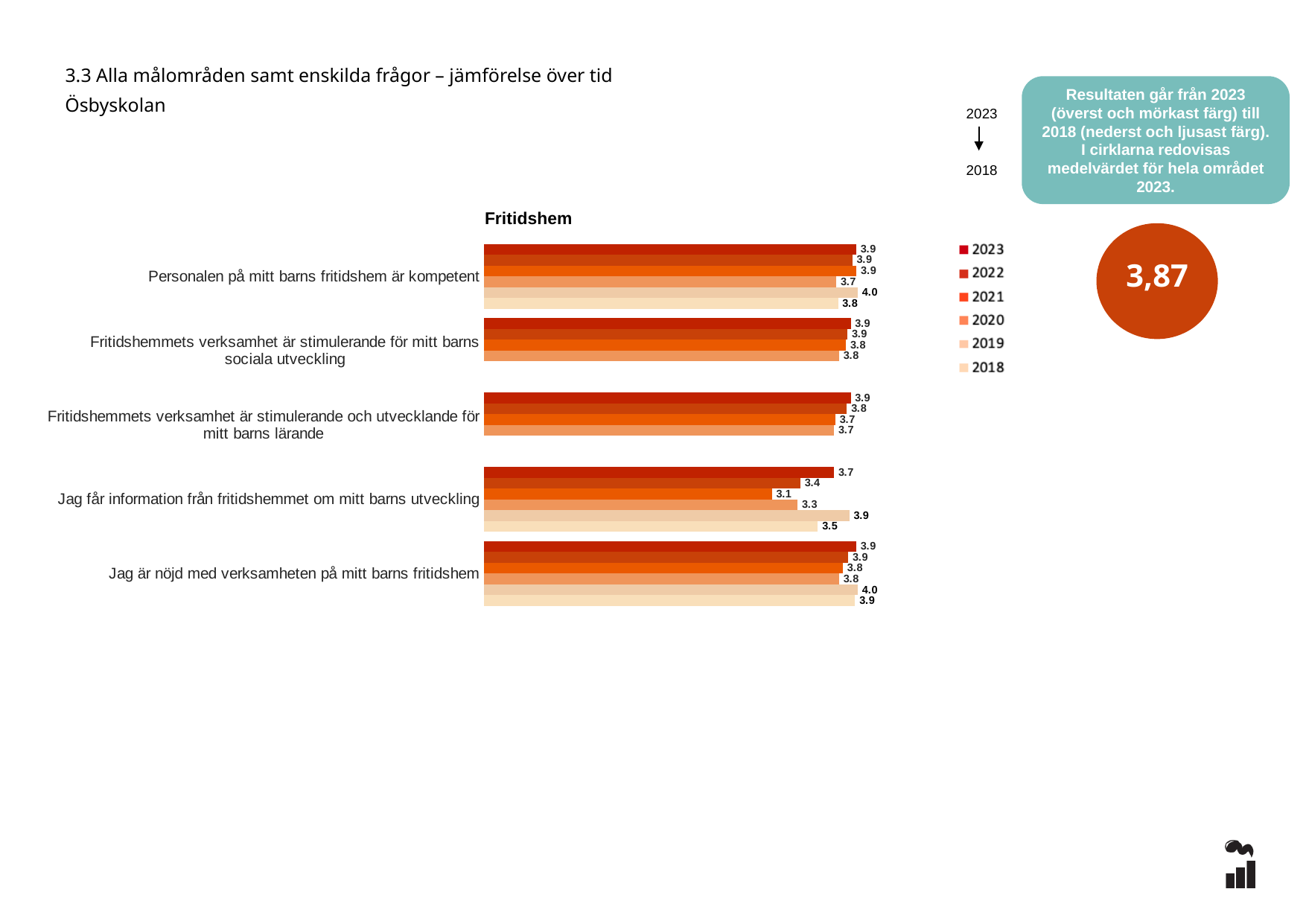
Which year has the highest value for "Jag får information från fritidshemmet om mitt barns utveckling"? 2019 How many years does the legend list? 6 What is the difference between the 2019 and 2021 values for "Jag får information från fritidshemmet om mitt barns utveckling"? 0.8 What is the 2020 value for "Fritidshemmets verksamhet är stimulerande och utvecklande för mitt barns lärande"? 3.7 What is the 2019 value for "Personalen på mitt barns fritidshem är kompetent"? 4.0 What is the title of the chart? Fritidshem Which year has the lowest value for "Jag får information från fritidshemmet om mitt barns utveckling"? 2021 What kind of chart is shown on the slide? Bar chart How many question categories are shown in the chart? 5 What is the 2023 value for "Jag får information från fritidshemmet om mitt barns utveckling"? 3.7 What is the 2021 value for "Jag får information från fritidshemmet om mitt barns utveckling"? 3.1 For 2023, which is larger: "Personalen på mitt barns fritidshem är kompetent" or "Jag får information från fritidshemmet om mitt barns utveckling"? Personalen på mitt barns fritidshem är kompetent